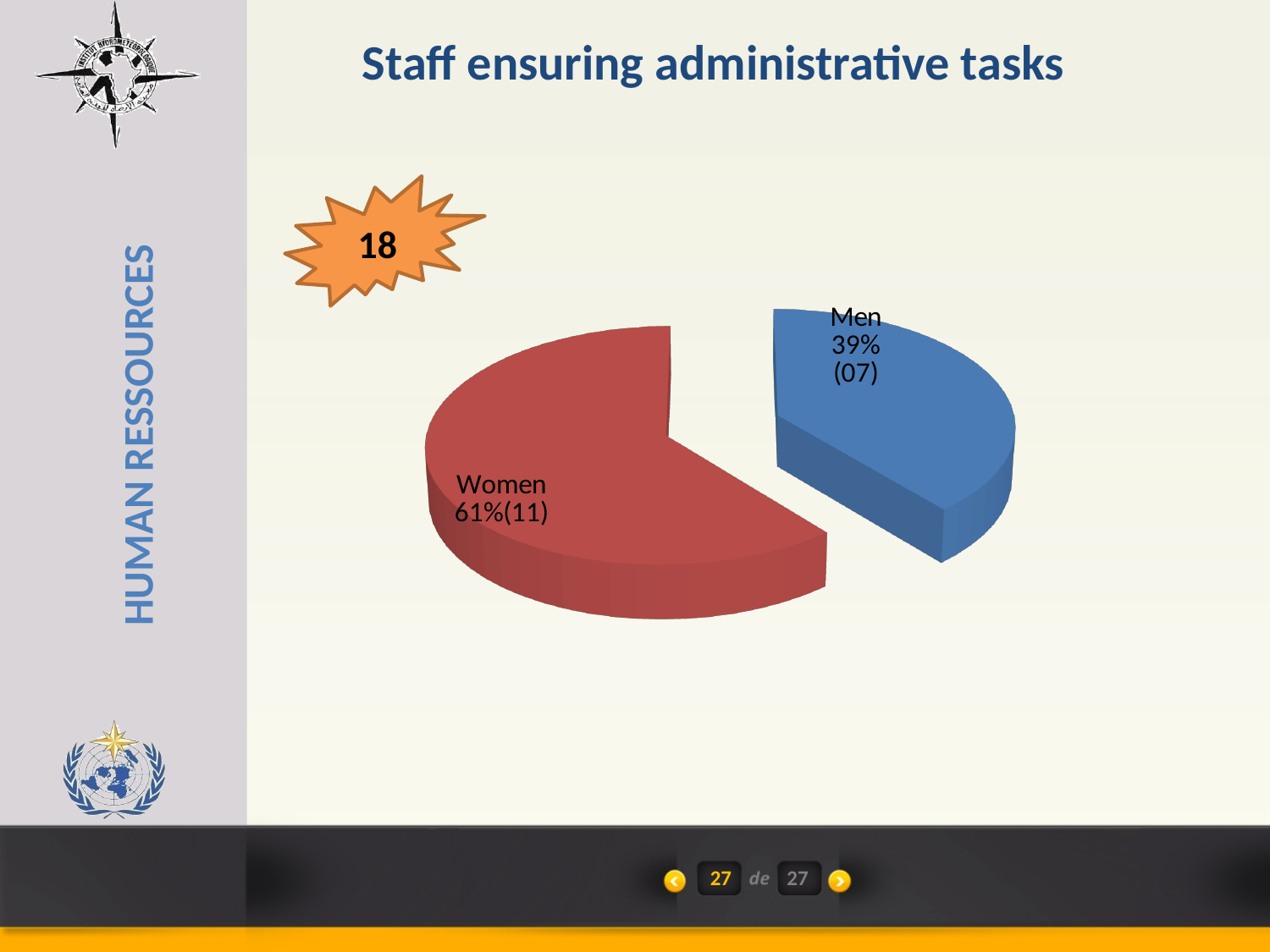
What kind of chart is shown on the slide? pie chart What colour is the Men slice? blue Which slice is the largest in the pie chart? Women Which slice is larger, Women or Men? Women How many slices does the pie chart have? 2 Which slice is the smallest in the pie chart? Men What percentage of the pie does the Men slice represent? 39% What is the difference in percentage points between the Women and Men slices? 22 What is the title of the chart? Staff ensuring administrative tasks How many staff are counted in the Women slice? 11 How many staff are counted in the Men slice? 07 What percentage of the pie does the Women slice represent? 61%